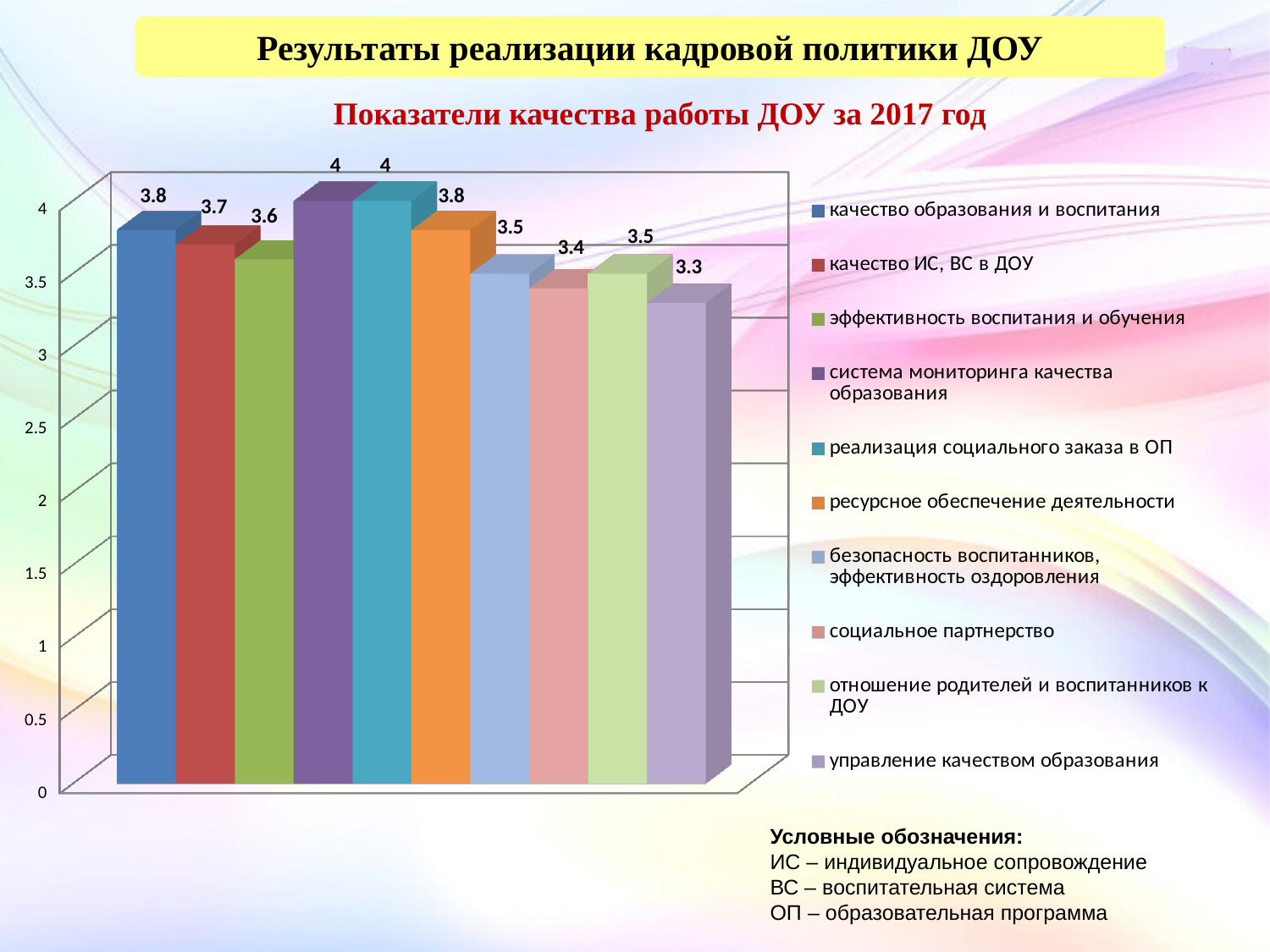
What kind of chart is shown on the slide? bar chart What is the value for эффективность воспитания и обучения? 3.6 What is the value for качество образования и воспитания? 3.8 What is the value for качество ИС, ВС в ДОУ? 3.7 Which series has the lowest value? управление качеством образования Which is larger: the value for ресурсное обеспечение деятельности or the value for безопасность воспитанников, эффективность оздоровления? ресурсное обеспечение деятельности What is the difference between the values for качество образования и воспитания and управление качеством образования? 0.5 What is the difference between the values for реализация социального заказа в ОП and социальное партнерство? 0.6 What is the title shown above the chart? Показатели качества работы ДОУ за 2017 год How many series does the legend list? 10 What is the value for система мониторинга качества образования? 4 What is the value for управление качеством образования? 3.3